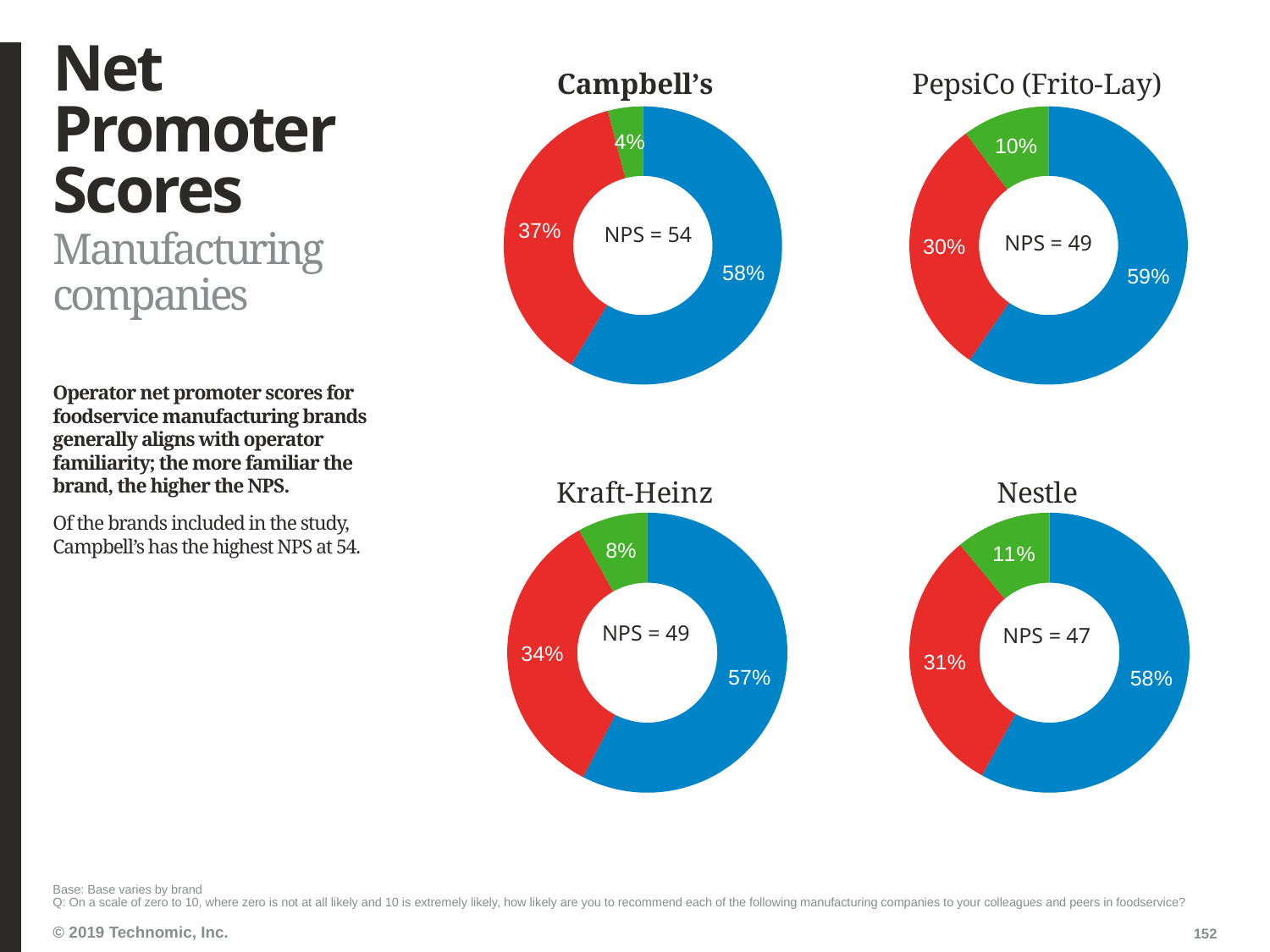
In the Campbell's chart, which slice is the smallest? The green slice (4%) In the Kraft-Heinz chart, what percentage does the green slice show? 8% Which chart shows the lowest NPS value in its centre? Nestle (NPS = 47) In the Nestle chart, which slice is the largest? The blue slice (58%) Which is larger: the green slice in the Nestle chart or the green slice in the PepsiCo (Frito-Lay) chart? Nestle (11%) In the Campbell's chart, what is the NPS shown in the centre? NPS = 54 In the PepsiCo (Frito-Lay) chart, what percentage does the blue slice show? 59% What kind of chart is used for Campbell's? Donut (pie) chart How many donut charts are on the slide? 4 In the Nestle chart, what percentage does the red slice show? 31% How many slices does the Kraft-Heinz chart have? 3 In the Campbell's chart, what is the difference between the blue slice and the red slice? 21 percentage points